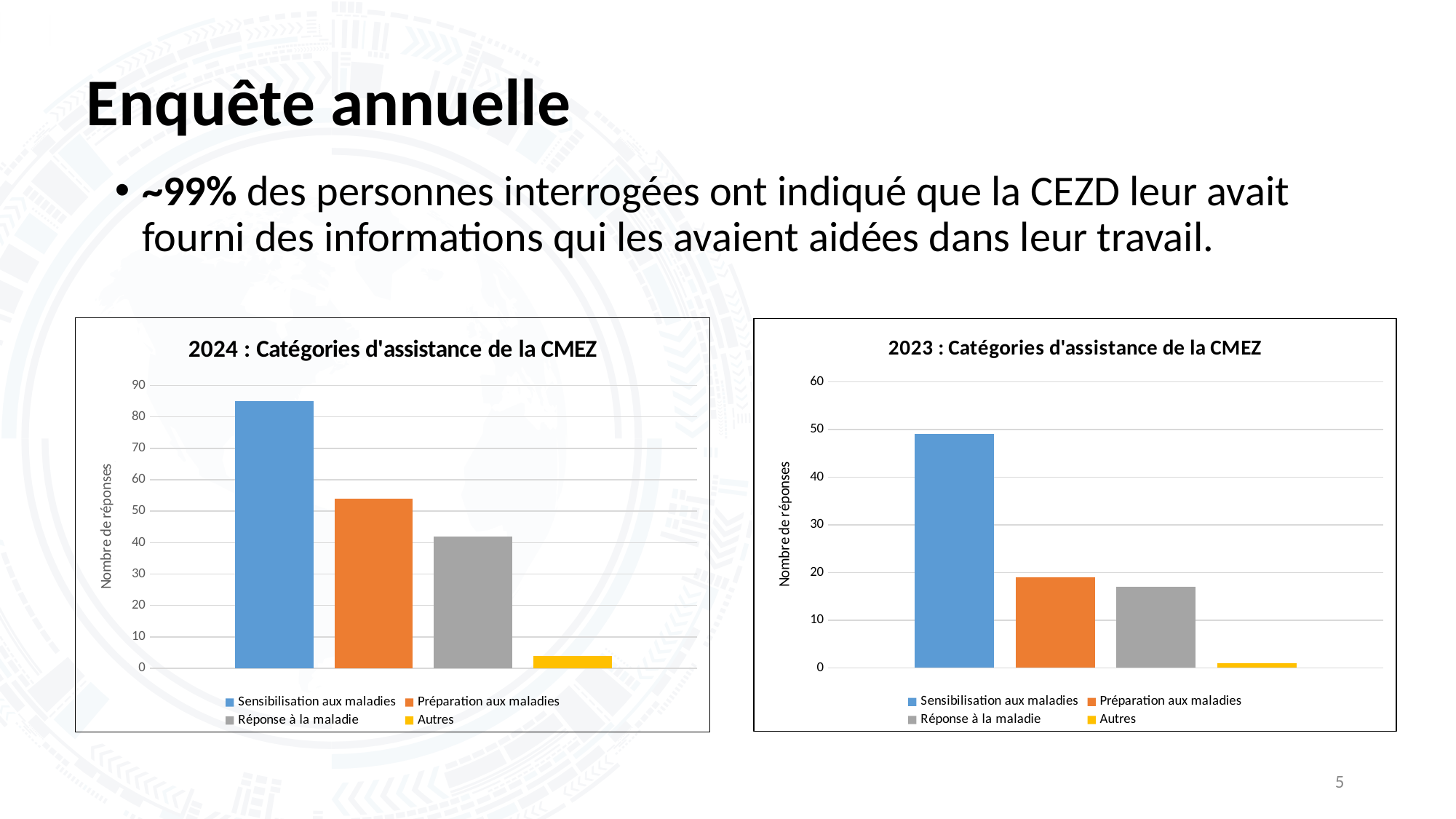
In the '2024 : Catégories d'assistance de la CMEZ' chart, is the value for Autres greater or less than 10? less In the '2023 : Catégories d'assistance de la CMEZ' chart, which category has the highest number of responses? Sensibilisation aux maladies What is the y-axis label of the '2024 : Catégories d'assistance de la CMEZ' chart? Nombre de réponses In the '2024 : Catégories d'assistance de la CMEZ' chart, is the value for Préparation aux maladies greater or less than 50? greater In the '2023 : Catégories d'assistance de la CMEZ' chart, is the value for Réponse à la maladie greater or less than 20? less How many entries does the legend of the '2023 : Catégories d'assistance de la CMEZ' chart list? 4 In the '2024 : Catégories d'assistance de la CMEZ' chart, which category has the highest number of responses? Sensibilisation aux maladies In the '2024 : Catégories d'assistance de la CMEZ' chart, which is larger: Préparation aux maladies or Réponse à la maladie? Préparation aux maladies In the '2024 : Catégories d'assistance de la CMEZ' chart, which category has the lowest number of responses? Autres What kind of chart is the '2024 : Catégories d'assistance de la CMEZ' chart? bar chart